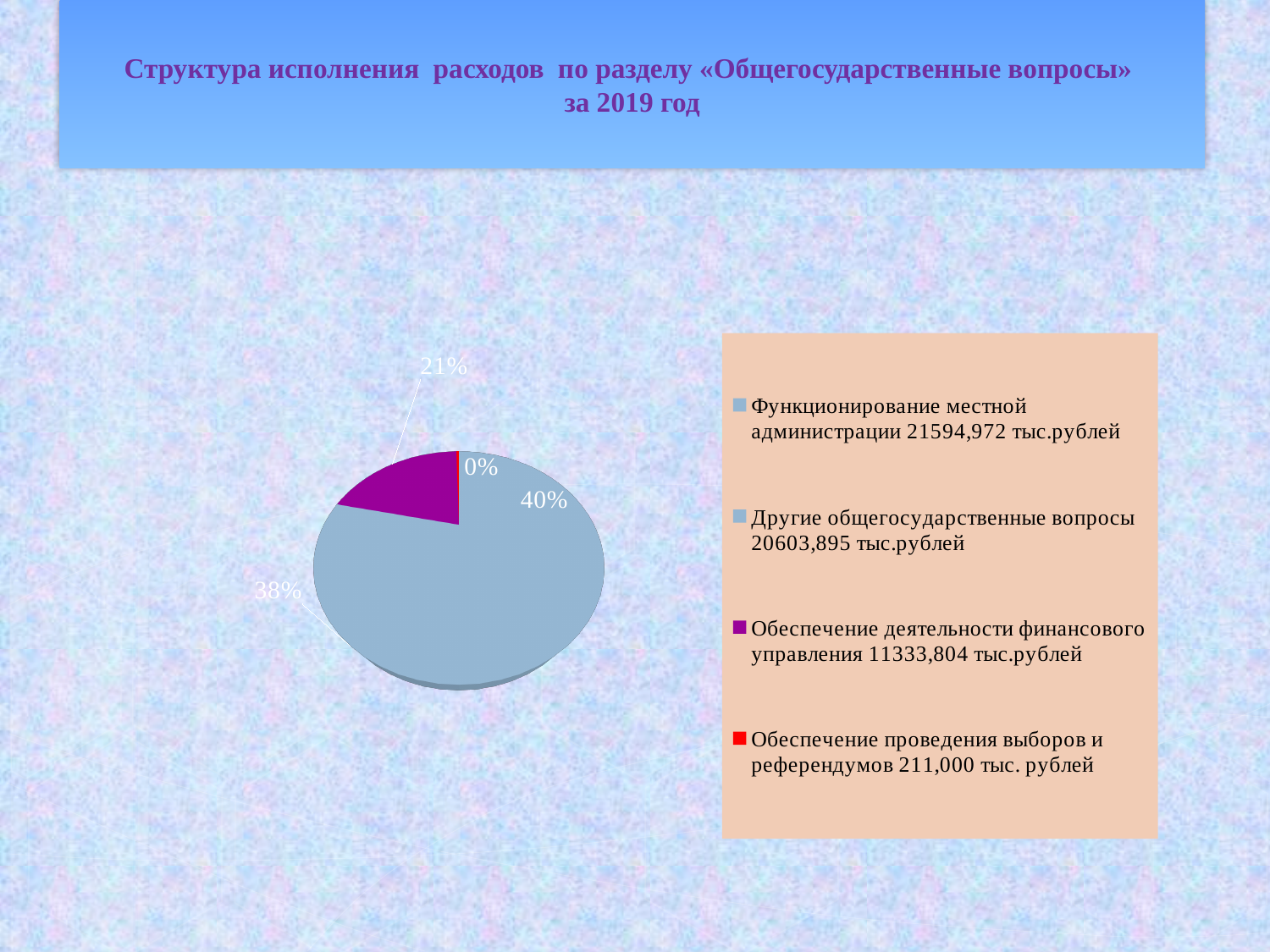
What kind of chart is shown on the slide? pie chart What share of the pie is labelled for the slice 'Обеспечение деятельности финансового управления'? 21% Which legend category has the smallest amount? Обеспечение проведения выборов и референдумов What amount does the legend give for 'Функционирование местной администрации'? 21594,972 тыс.рублей What is the title of the chart on the slide? Структура исполнения расходов по разделу «Общегосударственные вопросы» за 2019 год What share of the pie is labelled for the largest slice? 40% What amount does the legend give for 'Другие общегосударственные вопросы'? 20603,895 тыс.рублей How many slices does the pie chart have? 4 What share of the pie is labelled for the slice 'Обеспечение проведения выборов и референдумов'? 0% How many entries does the legend of the pie chart list? 4 Which is larger: the amount for 'Функционирование местной администрации' or for 'Обеспечение деятельности финансового управления'? Функционирование местной администрации What amount does the legend give for 'Обеспечение проведения выборов и референдумов'? 211,000 тыс. рублей